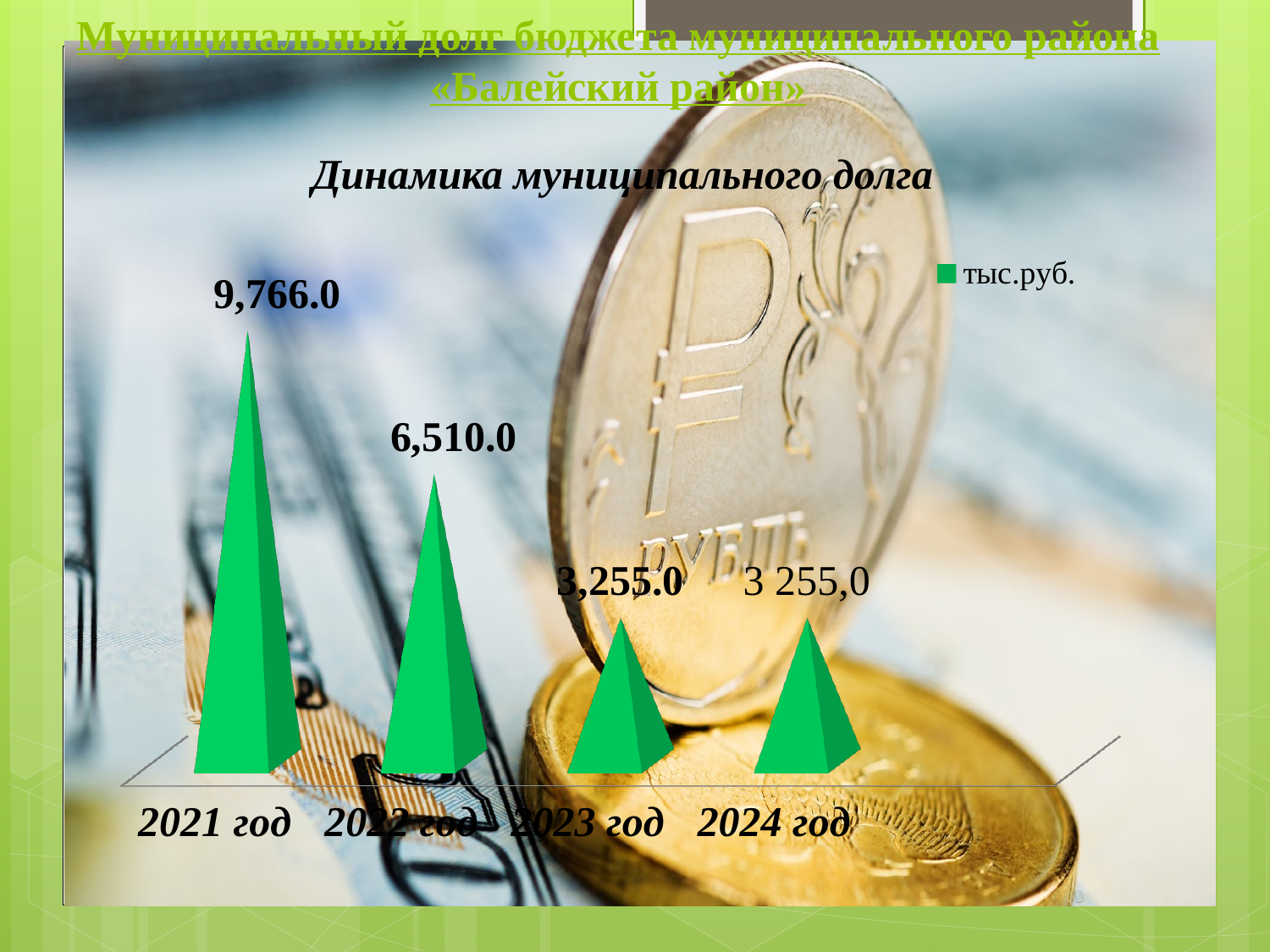
Which is larger, the value for 2022 год or the value for 2023 год? 2022 год What is the difference between the values for 2022 год and 2023 год? 3,255.0 What is the value for 2023 год? 3,255.0 What is the value shown for 2024 год? 3 255,0 Which year has the highest value? 2021 год How many years are shown on the x axis? 4 What is the difference between the values for 2021 год and 2022 год? 3,256.0 What kind of chart is shown on the slide? bar chart What is the value for 2022 год? 6,510.0 What is the value for 2021 год? 9,766.0 What is the title of the chart on the slide? Динамика муниципального долга How many series does the legend list? 1